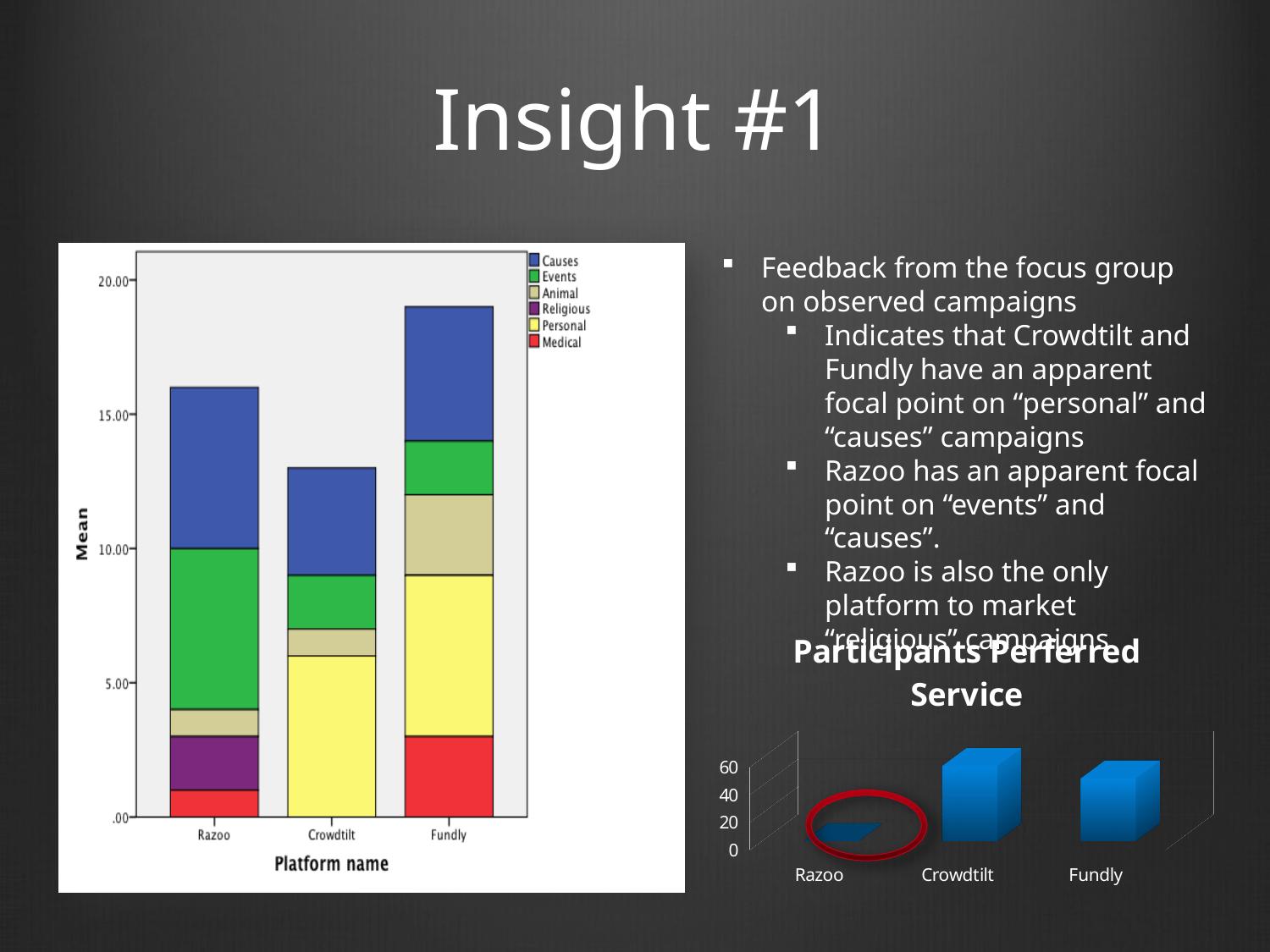
In the left chart (Mean by Platform name), is the total for Crowdtilt greater or less than 15.00? less In the left chart (Mean by Platform name), what is the label of the y axis? Mean In the left chart (Mean by Platform name), which platform is the only one with a Religious segment? Razoo In the chart titled 'Participants Perferred Service', which platform has the highest bar? Crowdtilt In the left chart (Mean by Platform name), is the total for Fundly greater or less than 15.00? greater In the left chart (Mean by Platform name), which platform has the tallest stacked bar? Fundly In the left chart (Mean by Platform name), which platform has the shortest stacked bar? Crowdtilt In the left chart (Mean by Platform name), how many series does the legend list? 6 In the chart titled 'Participants Perferred Service', which platform has the lowest bar? Razoo What kind of chart is the left chart (Mean by Platform name)? Stacked bar chart In the left chart (Mean by Platform name), how many platforms are shown on the x axis? 3 In the chart titled 'Participants Perferred Service', is the value for Razoo greater or less than 20? less